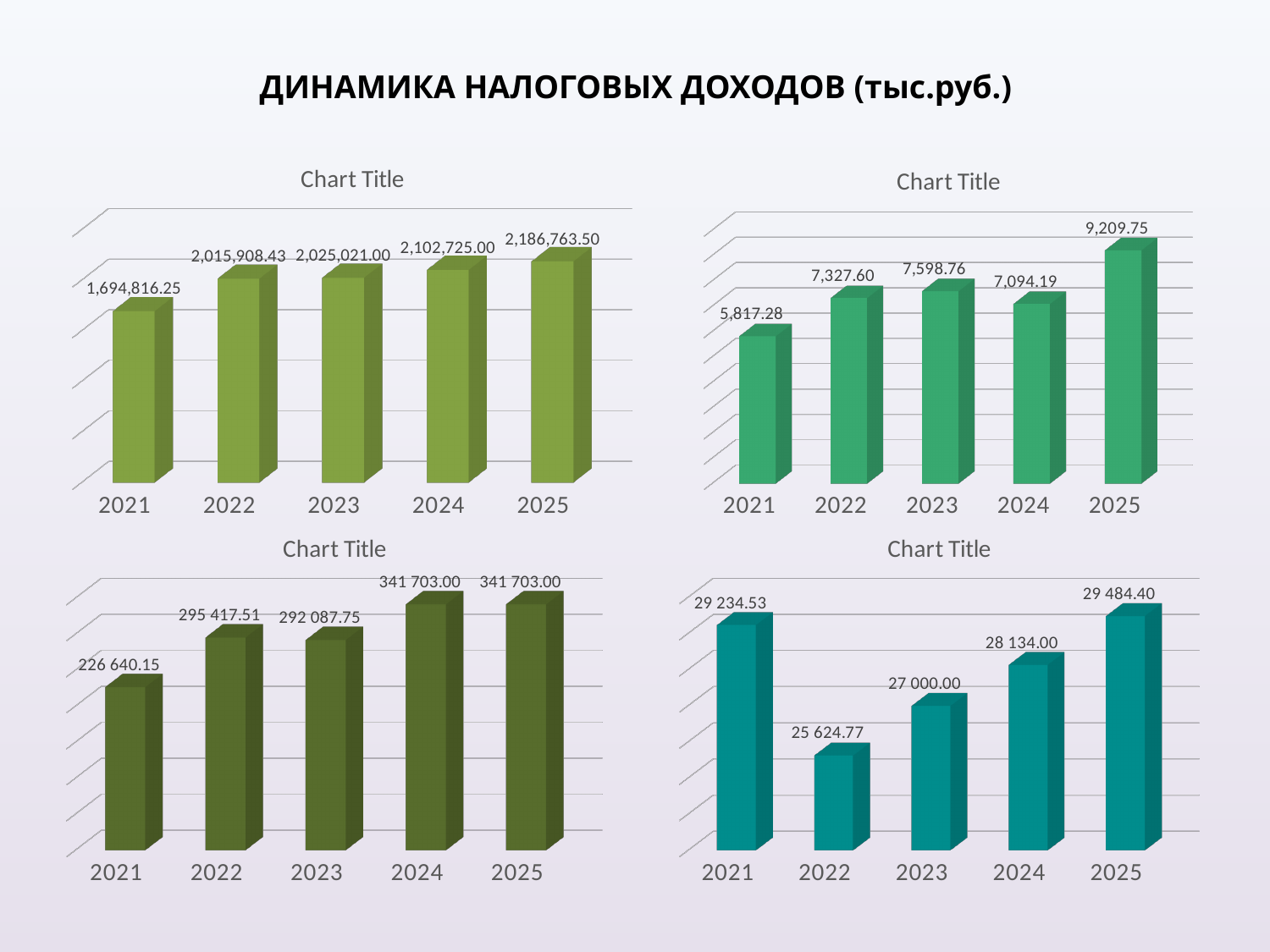
In the top-right chart, what is the value for 2025? 9,209.75 In the top-left chart, what is the value for 2021? 1,694,816.25 What kind of chart is the bottom-left chart? Bar chart How many years are shown on the x axis of the top-left chart? 5 In the bottom-right chart, what is the difference between the values for 2025 and 2021? 249.87 In the top-left chart, which year has the highest value? 2025 In the top-right chart, which year has the lowest value? 2021 In the bottom-right chart, what is the value for 2023? 27 000.00 In the bottom-right chart, which year has the lowest value? 2022 In the bottom-left chart, what is the difference between the values for 2024 and 2021? 115 062.85 In the top-right chart, which is larger, the value for 2023 or the value for 2024? 2023 In the bottom-left chart, what is the value for 2022? 295 417.51